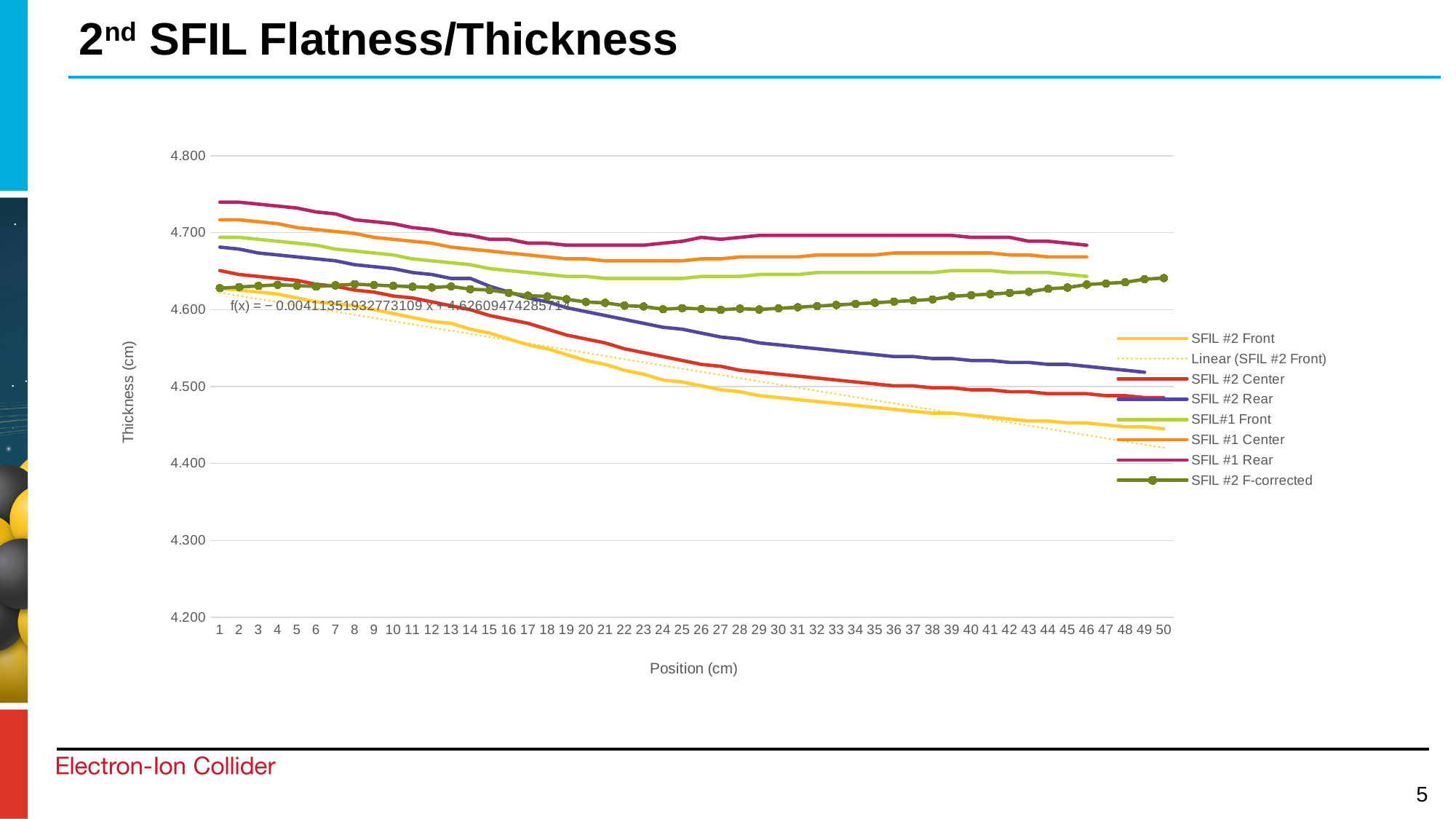
Which series has the highest thickness at position 1? SFIL #1 Rear Is the value of SFIL #2 Front at position 50 greater or less than 4.500? less What kind of chart is shown on the slide? line chart At position 1, which is larger: SFIL #1 Rear or SFIL #2 Front? SFIL #1 Rear How many positions are labelled along the x axis of the chart? 50 Is the value of SFIL #2 F-corrected at position 25 greater or less than 4.500? greater Does the SFIL #2 Center series rise or fall as position increases along the x axis? fall How many series does the chart legend list? 8 Does the SFIL #2 Front series rise or fall as position increases along the x axis? fall What is the label of the x axis of the chart? Position (cm) What is the label of the y axis of the chart? Thickness (cm) Is the value of SFIL #1 Rear at position 1 greater or less than 4.700? greater